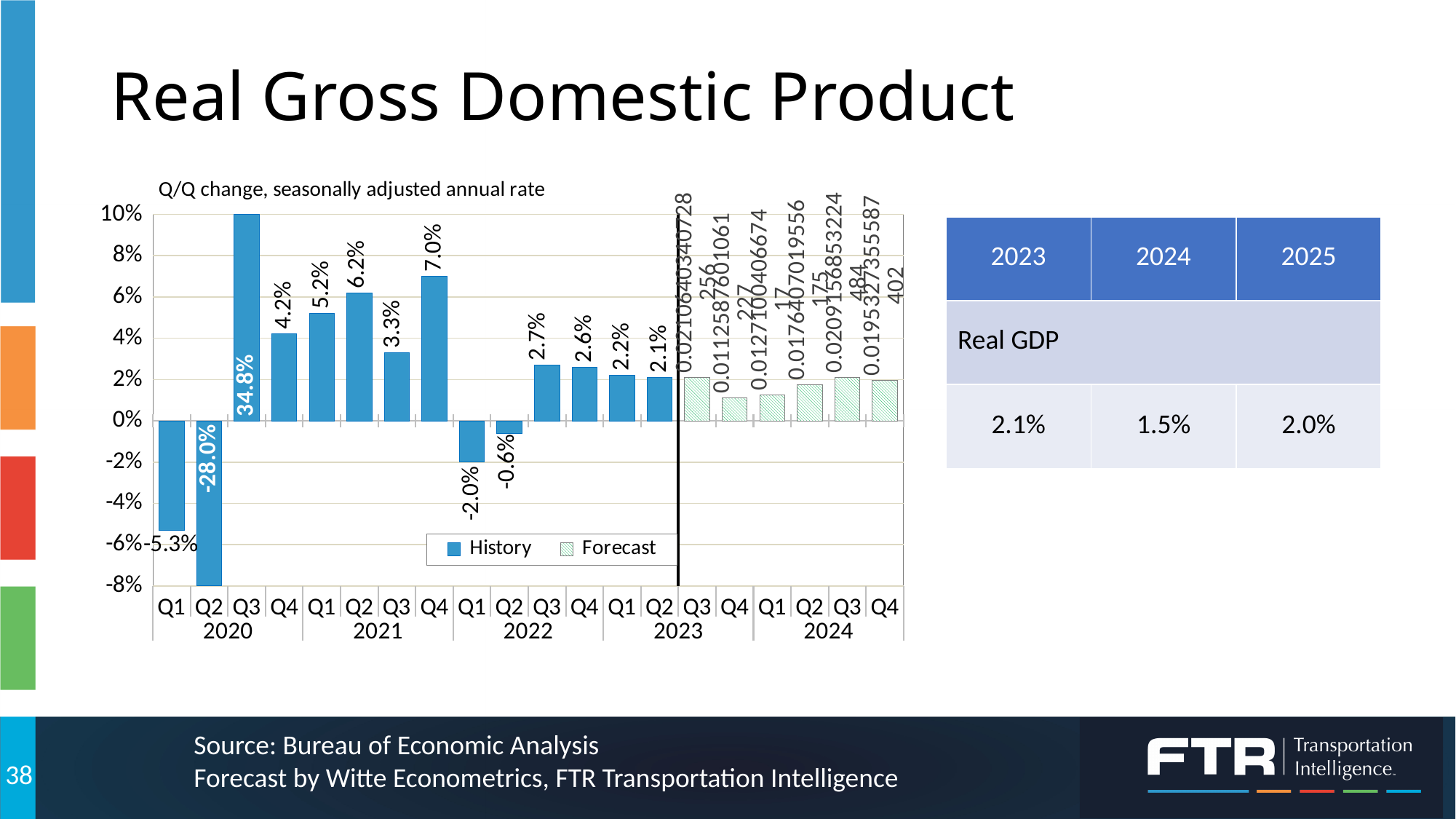
Which is larger, the Q/Q change for Q1 2021 or Q4 2020? Q1 2021 What is the Q/Q change in real GDP for Q4 2021? 7.0% What is the Q/Q change in real GDP for Q2 2020? -28.0% What kind of chart is shown on the slide? Bar chart What is the Q/Q change in real GDP for Q2 2023? 2.1% What is the difference between the Q/Q change for Q2 2021 and Q3 2021? 2.9% Is the value for Q3 2020 greater or less than 8%? greater Which quarter has the lowest Q/Q change in real GDP on the chart? Q2 2020 Do the values rise or fall from Q3 2022 to Q2 2023? Fall Which quarter has the highest Q/Q change in real GDP on the chart? Q3 2020 How many series does the chart legend list? 2 What are the two series named in the chart legend? History and Forecast